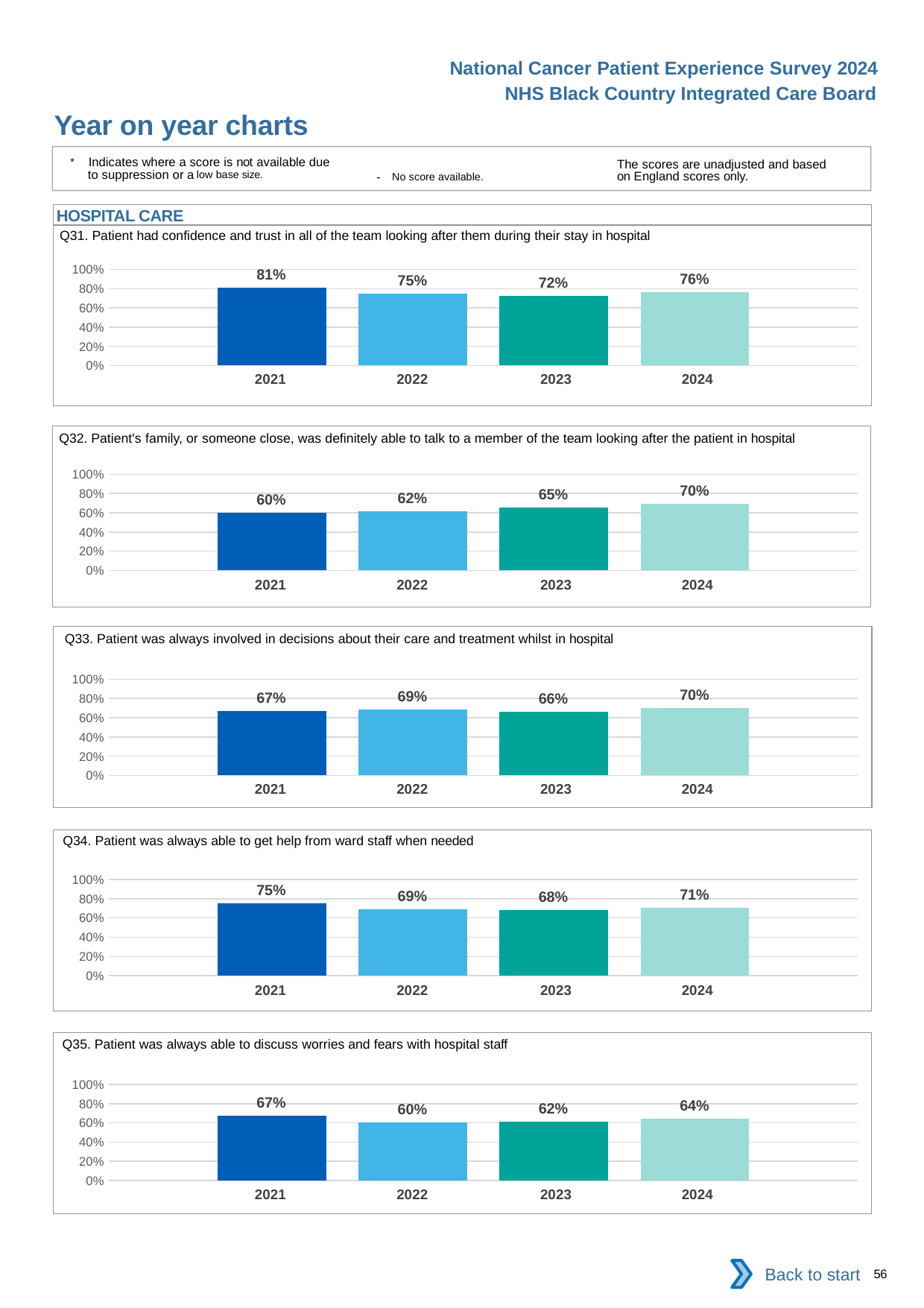
In the Q32 chart, what is the difference between the 2024 and 2021 values? 10 percentage points In the Q33 chart, which year has the highest value? 2024 In the Q31 chart, which year has the lowest value? 2023 In the Q32 chart, do the values rise or fall from 2021 to 2024? rise In the Q32 chart, what is the value for 2024? 70% In the Q34 chart, what is the difference between the 2021 and 2023 values? 7 percentage points In the Q34 chart, which is larger, the value for 2021 or the value for 2024? 2021 How many years are shown in the Q35 chart? 4 In the Q35 chart, what is the value for 2022? 60% What type of chart is used for Q31? bar chart In the Q31 chart, what is the value for 2021? 81% In the Q33 chart, what is the value for 2023? 66%